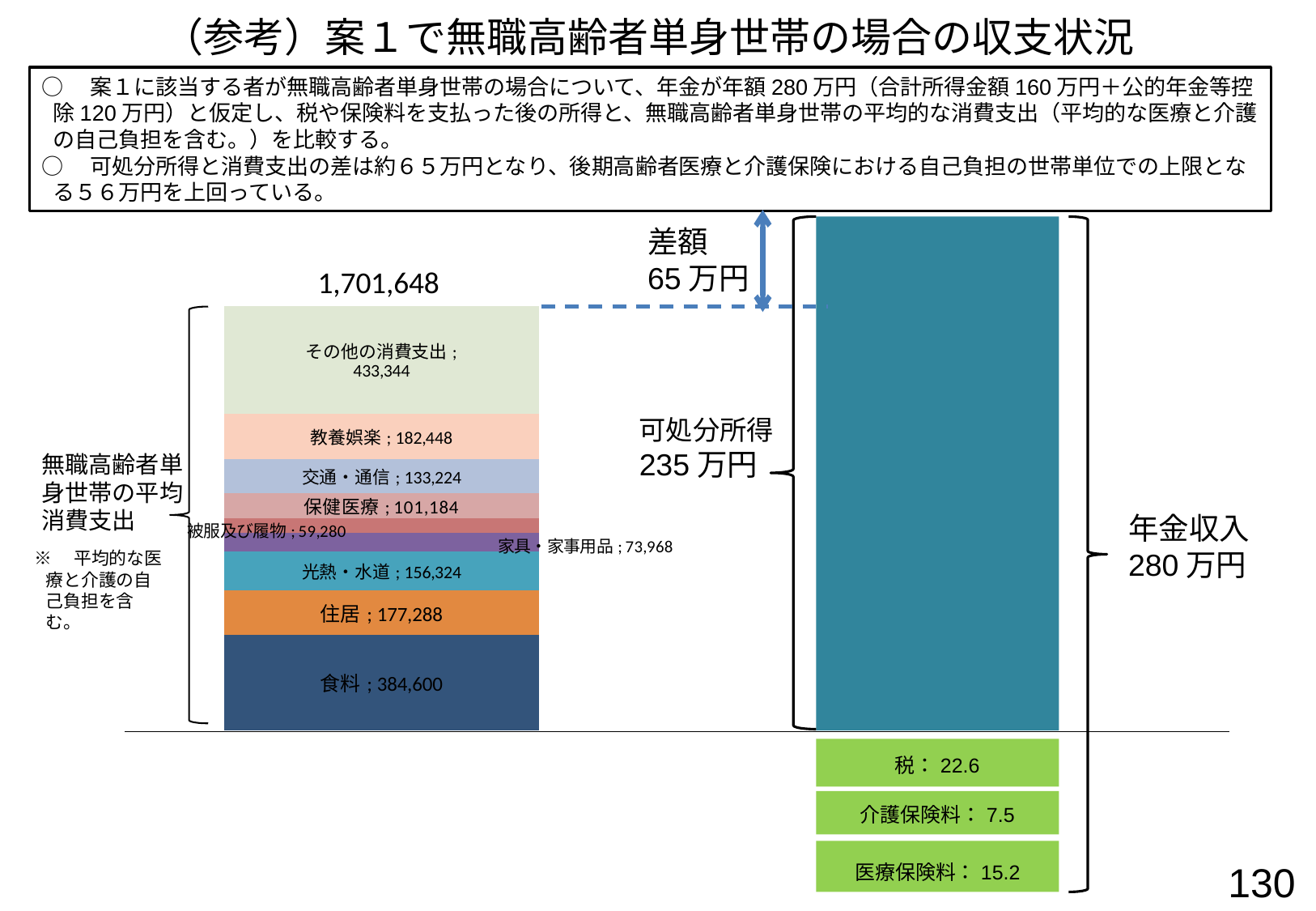
What kind of chart is used to show the average consumption expenditure? Stacked bar chart Which segment of the stacked consumption expenditure bar has the smallest value? 被服及び履物 What is the total of the stacked bar showing the average consumption expenditure of a non-working elderly single household? 1,701,648 Which segment of the stacked consumption expenditure bar has the largest value? その他の消費支出 What is the value for 交通・通信 in the stacked consumption expenditure bar? 133,224 What is the value shown for 医療保険料 below the pension income bar? 15.2 Which is larger in the stacked consumption expenditure bar, 教養娯楽 or 住居? 教養娯楽 How many expenditure segments make up the stacked consumption expenditure bar? 9 What is the value shown for 税 (tax) below the pension income bar? 22.6 What is the value for 食料 (food) in the stacked consumption expenditure bar? 384,600 What is the difference between 食料 and 住居 in the stacked consumption expenditure bar? 207,312 What is the value for 住居 (housing) in the stacked consumption expenditure bar? 177,288